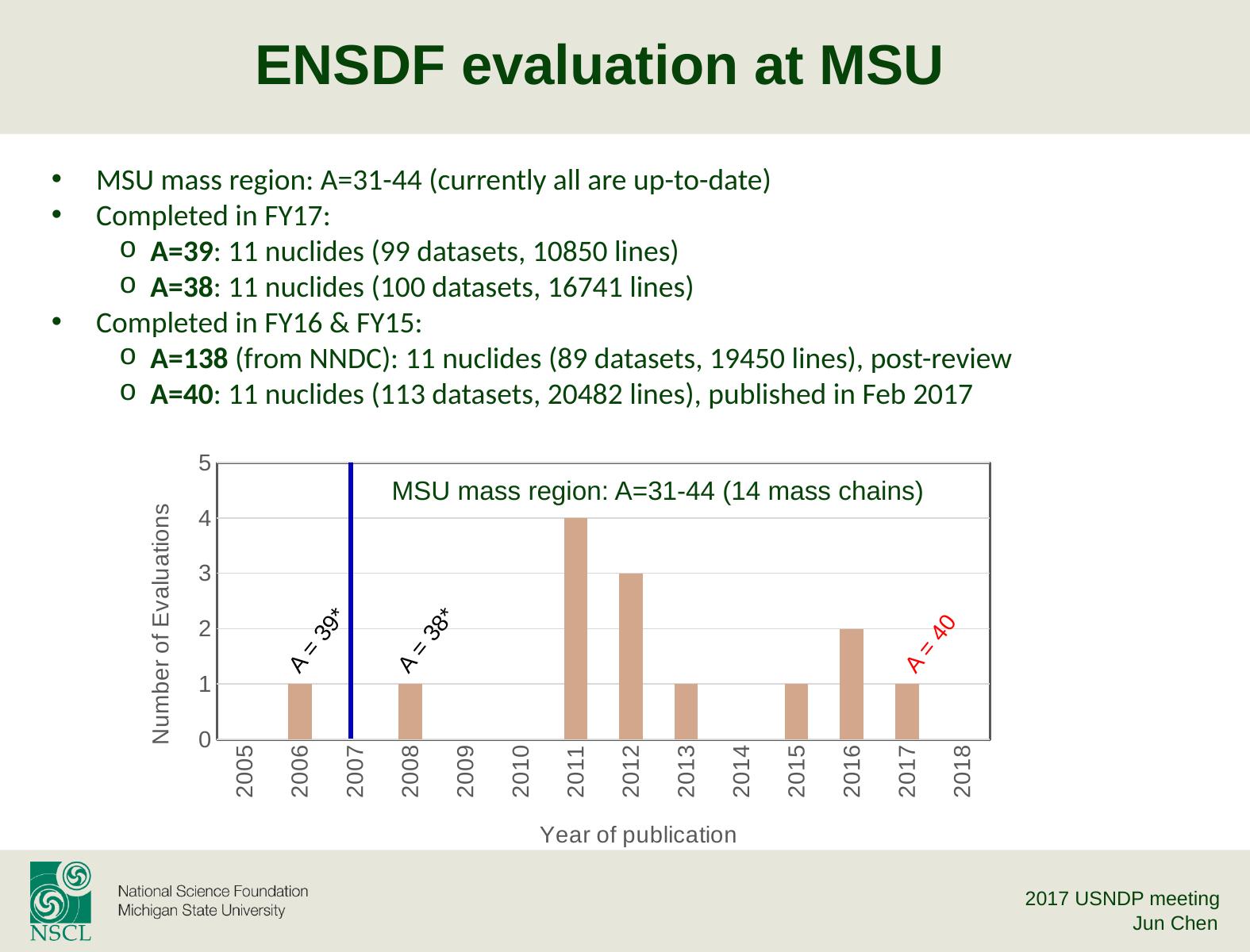
Which year has the highest number of evaluations? 2011 What is the number of evaluations for 2012? 3 What is the number of evaluations for 2017? 1 How many years on the x axis have a bar with a non-zero number of evaluations? 8 What kind of chart is shown on the slide? bar chart How many years are labelled on the x axis? 14 What is the number of evaluations for 2011? 4 Which mass chain is labelled in red on the chart? A = 40 What is the number of evaluations for 2016? 2 What is the difference in number of evaluations between 2011 and 2012? 1 Which year has more evaluations, 2016 or 2013? 2016 What is the label of the y axis? Number of Evaluations